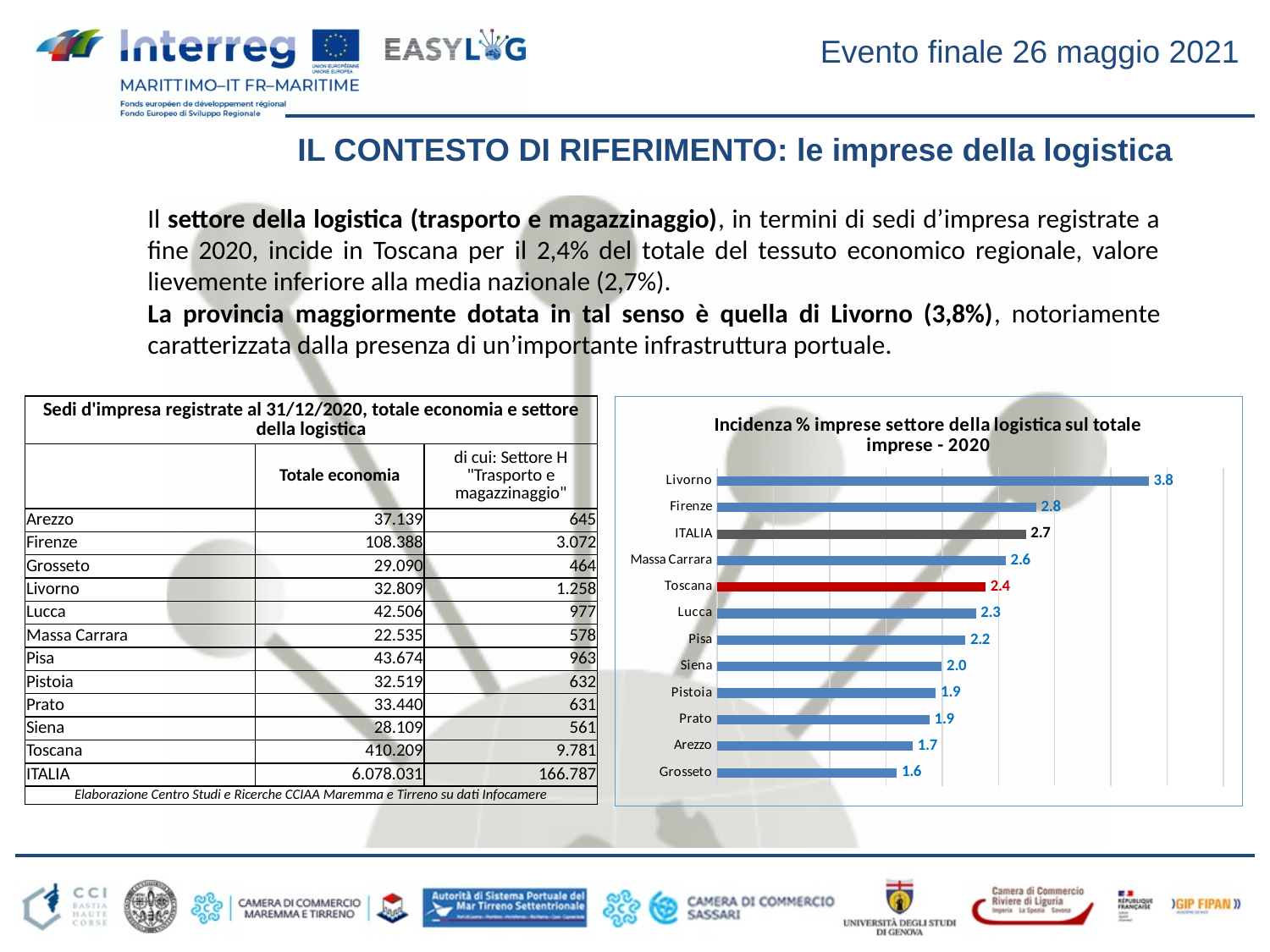
What is the value for Toscana in the chart? 2.4 How many categories are shown in the chart? 12 What is the title of the chart? Incidenza % imprese settore della logistica sul totale imprese - 2020 What is the value for Massa Carrara in the chart? 2.6 Which category has the highest value in the chart? Livorno Which has a larger value, Firenze or Lucca? Firenze What is the value for ITALIA in the chart? 2.7 What is the difference between the values for ITALIA and Toscana? 0.3 What is the difference between the values for Livorno and Grosseto? 2.2 Which category has the lowest value in the chart? Grosseto What is the value for Livorno in the chart? 3.8 What kind of chart is shown on the slide? Bar chart